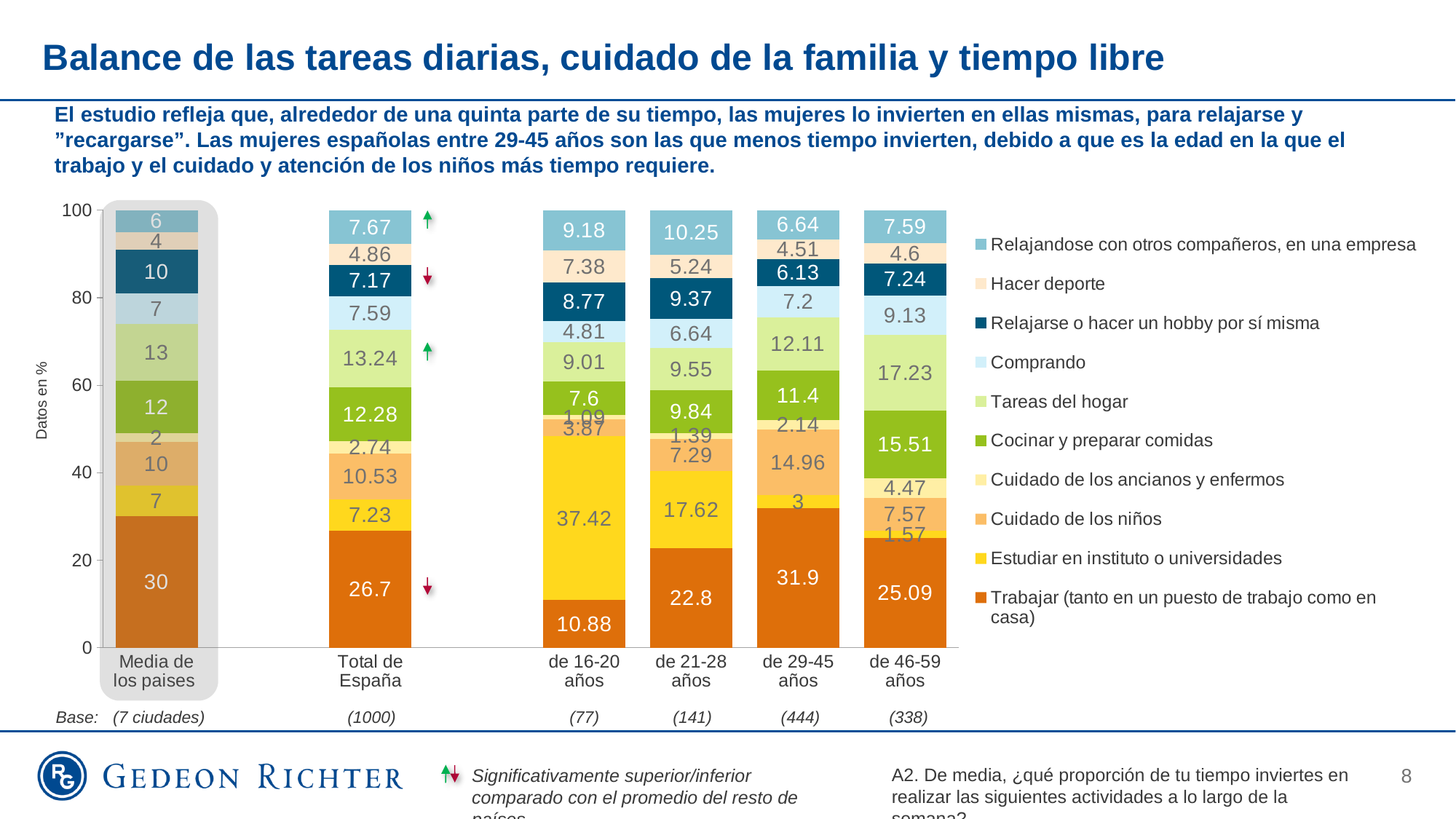
What is the label of the y axis? Datos en % What is the difference between the "Trabajar" values for "de 29-45 años" and "de 16-20 años"? 21.02 How many categories (bars) are shown on the x axis? 6 Which category has the highest value for "Trabajar (tanto en un puesto de trabajo como en casa)"? de 29-45 años What is the value for "Estudiar en instituto o universidades" in the "de 16-20 años" bar? 37.42 What kind of chart is shown on the slide? Stacked bar chart Which has the larger value for "Tareas del hogar": "de 46-59 años" or "de 29-45 años"? de 46-59 años What is the value for "Trabajar (tanto en un puesto de trabajo como en casa)" in the "Total de España" bar? 26.7 How many series does the legend list? 10 Which category has the lowest value for "Trabajar (tanto en un puesto de trabajo como en casa)"? de 16-20 años What is the value for "Relajandose con otros compañeros, en una empresa" in the "de 21-28 años" bar? 10.25 What is the value for "Cuidado de los niños" in the "de 29-45 años" bar? 14.96